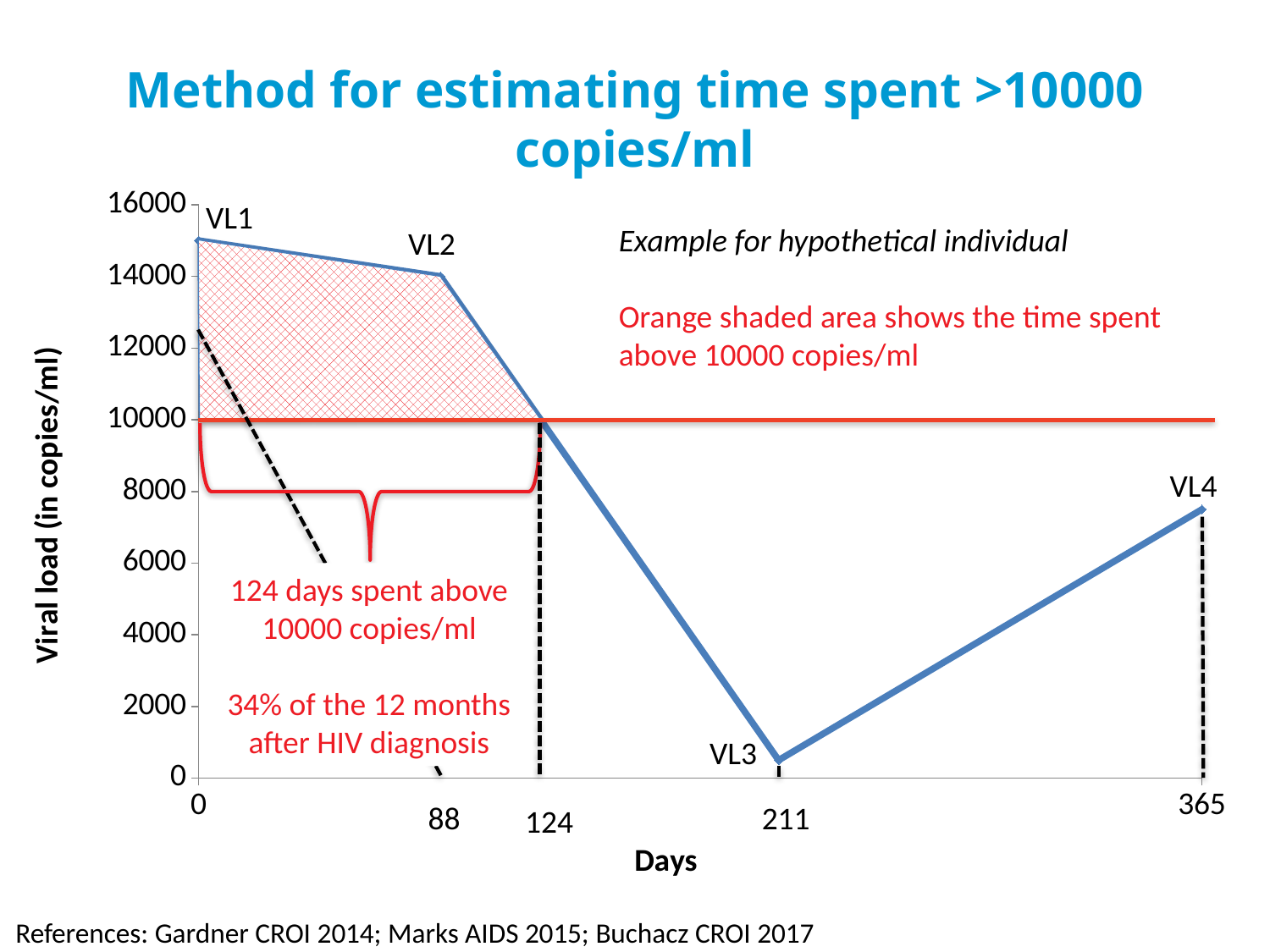
Is the viral load at VL1 greater or less than 14000? greater On which day does the viral load line cross the 10000 copies/ml threshold line? 124 On which day does VL3 occur? 211 How many labelled viral load points (VL1–VL4) are plotted on the chart? 4 Is the viral load at VL3 greater or less than 2000? less What is the label of the y axis? Viral load (in copies/ml) What kind of chart is shown on the slide? line chart Does the viral load rise or fall between VL2 and VL3? falls Which labelled point has the highest viral load? VL1 What is the label of the x axis? Days Which labelled point has the lowest viral load? VL3 On which day does VL2 occur? 88